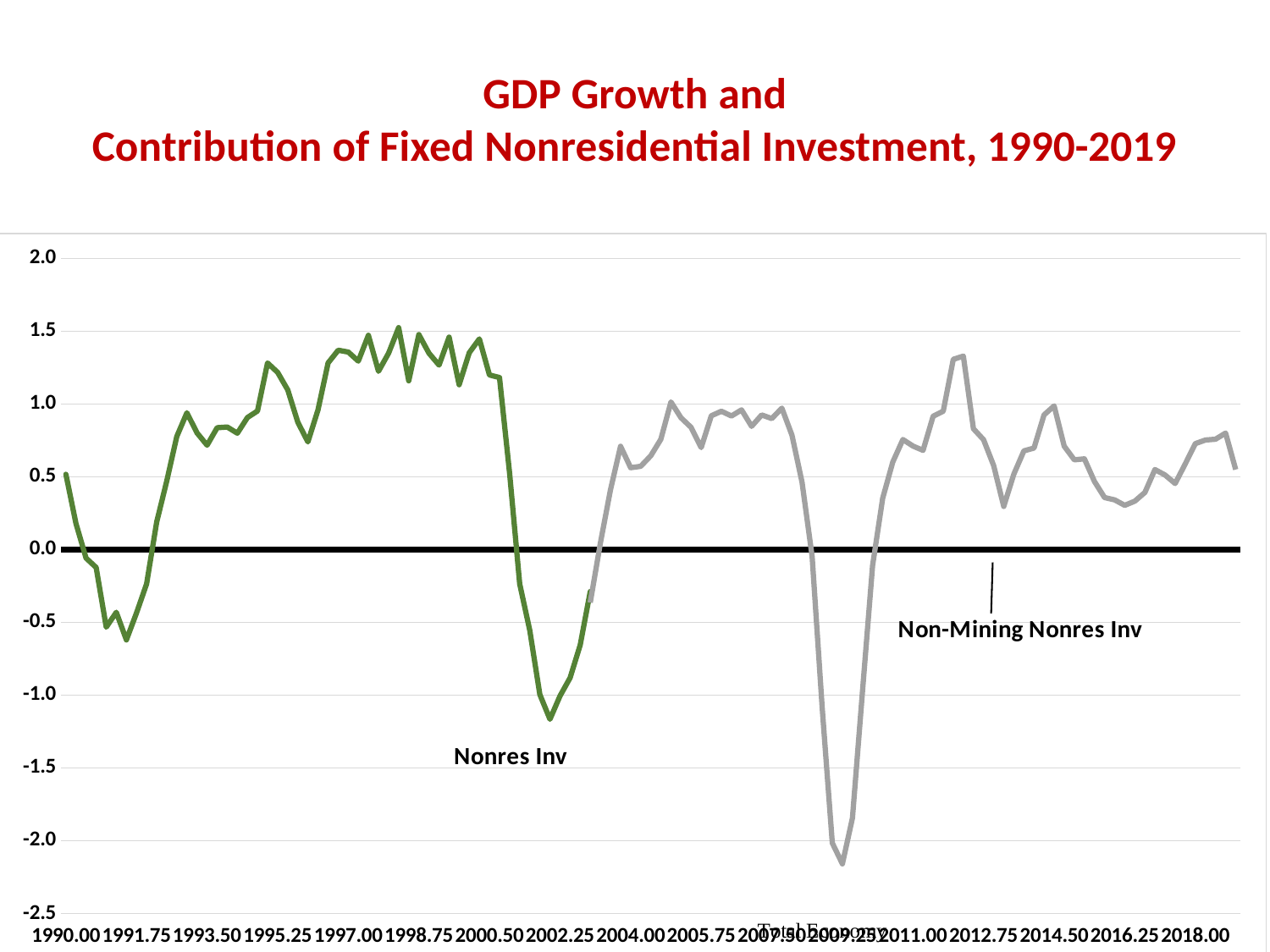
What is the highest value shown on the vertical axis? 2.0 Is the lowest value of the Non-Mining Nonres Inv line, around 2009, greater or less than -2.0? less Does the Non-Mining Nonres Inv line rise or fall between 2007.50 and 2009.25? fall Is the value of the Nonres Inv line at 1991.75 greater or less than 0.0? less What are the two series labelled on the chart? Nonres Inv and Non-Mining Nonres Inv Does the Nonres Inv line rise or fall between 1991.75 and 1993.50? rise Which line reaches the lower minimum value, Nonres Inv or Non-Mining Nonres Inv? Non-Mining Nonres Inv Is the peak of the Non-Mining Nonres Inv line around 2012 greater or less than 1.0? greater What is the title of the chart? GDP Growth and Contribution of Fixed Nonresidential Investment, 1990-2019 What kind of chart is shown on the slide? line chart